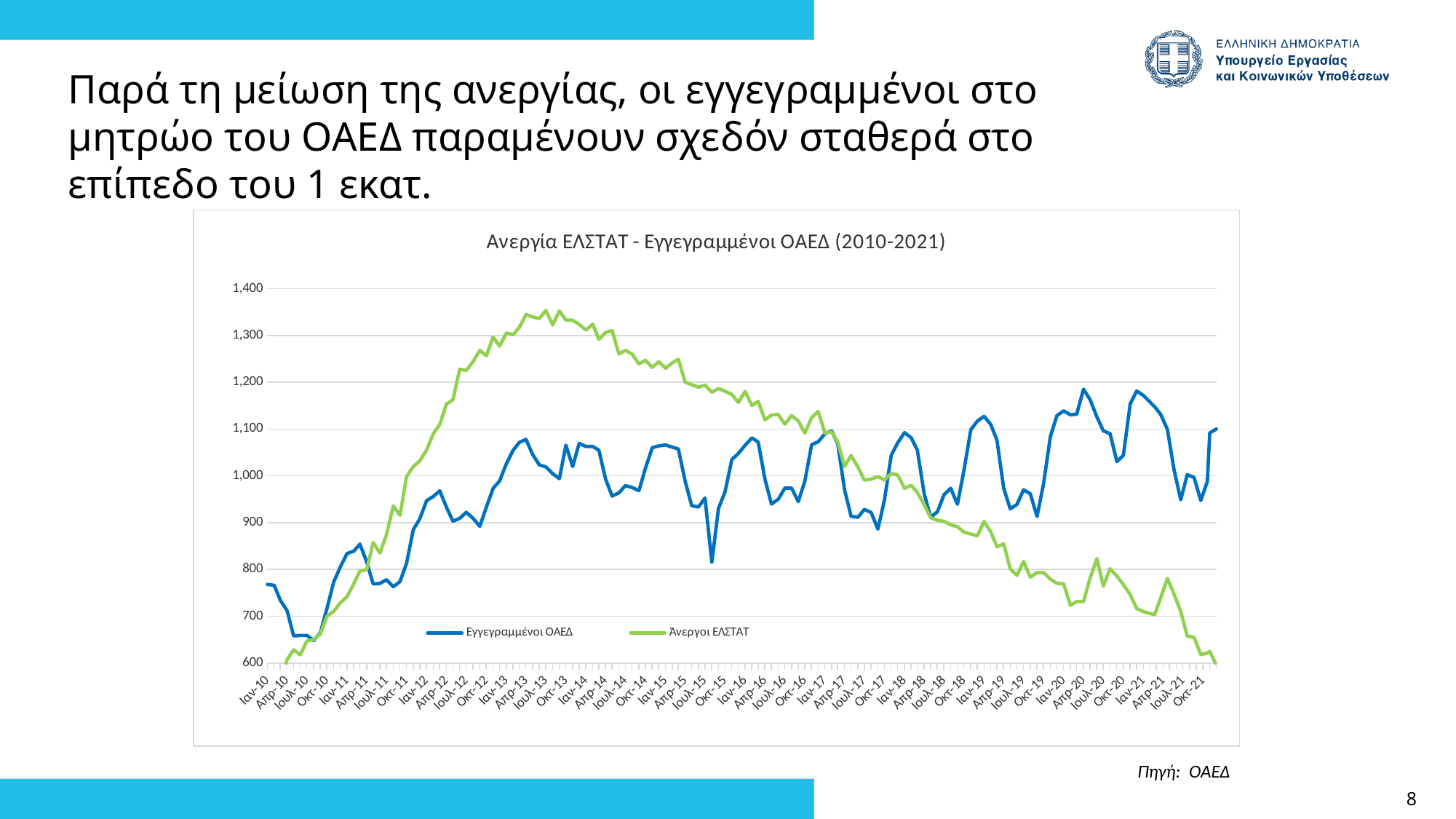
What is the title of the chart? Ανεργία ΕΛΣΤΑΤ - Εγγεγραμμένοι ΟΑΕΔ (2010-2021) Is the value of Εγγεγραμμένοι ΟΑΕΔ at Απρ-20 greater or less than 1,100? greater Is the value of Εγγεγραμμένοι ΟΑΕΔ at Ιαν-10 greater or less than 800? less Which series is drawn in green in the chart? Άνεργοι ΕΛΣΤΑΤ At Ιαν-13, which series has the larger value, Εγγεγραμμένοι ΟΑΕΔ or Άνεργοι ΕΛΣΤΑΤ? Άνεργοι ΕΛΣΤΑΤ What kind of chart is shown on the slide? Line chart At Οκτ-21, which series has the larger value, Εγγεγραμμένοι ΟΑΕΔ or Άνεργοι ΕΛΣΤΑΤ? Εγγεγραμμένοι ΟΑΕΔ Is the value of Άνεργοι ΕΛΣΤΑΤ at Οκτ-21 greater or less than 700? less How many series does the chart's legend list? 2 Which series reaches the highest value anywhere on the chart? Άνεργοι ΕΛΣΤΑΤ Does the Άνεργοι ΕΛΣΤΑΤ line rise or fall between Ιουλ-13 and Οκτ-21? Fall